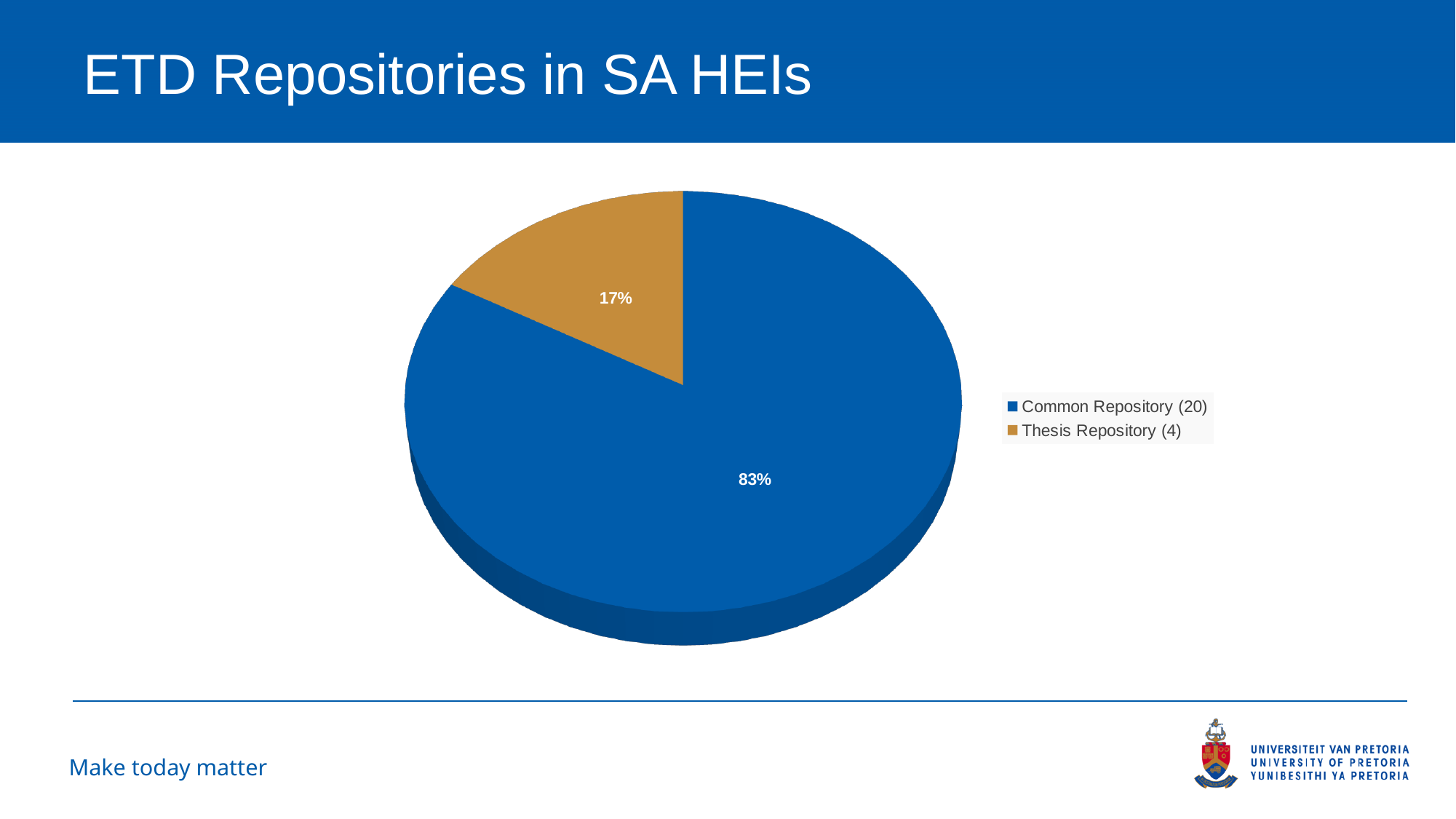
Which slice of the pie is the largest? Common Repository (20) What colour is the Thesis Repository slice? Gold/brown What is the difference in percentage points between the Common Repository slice and the Thesis Repository slice? 66 Which is larger, the Common Repository slice or the Thesis Repository slice? Common Repository What is the title of the slide containing the chart? ETD Repositories in SA HEIs What percentage of the pie does Common Repository (20) account for? 83% What percentage of the pie does Thesis Repository (4) account for? 17% How many entries does the legend list? 2 What kind of chart is shown on the slide? Pie chart How many institutions does the legend give for Common Repository? 20 How many slices does the pie chart have? 2 Which slice of the pie is the smallest? Thesis Repository (4)